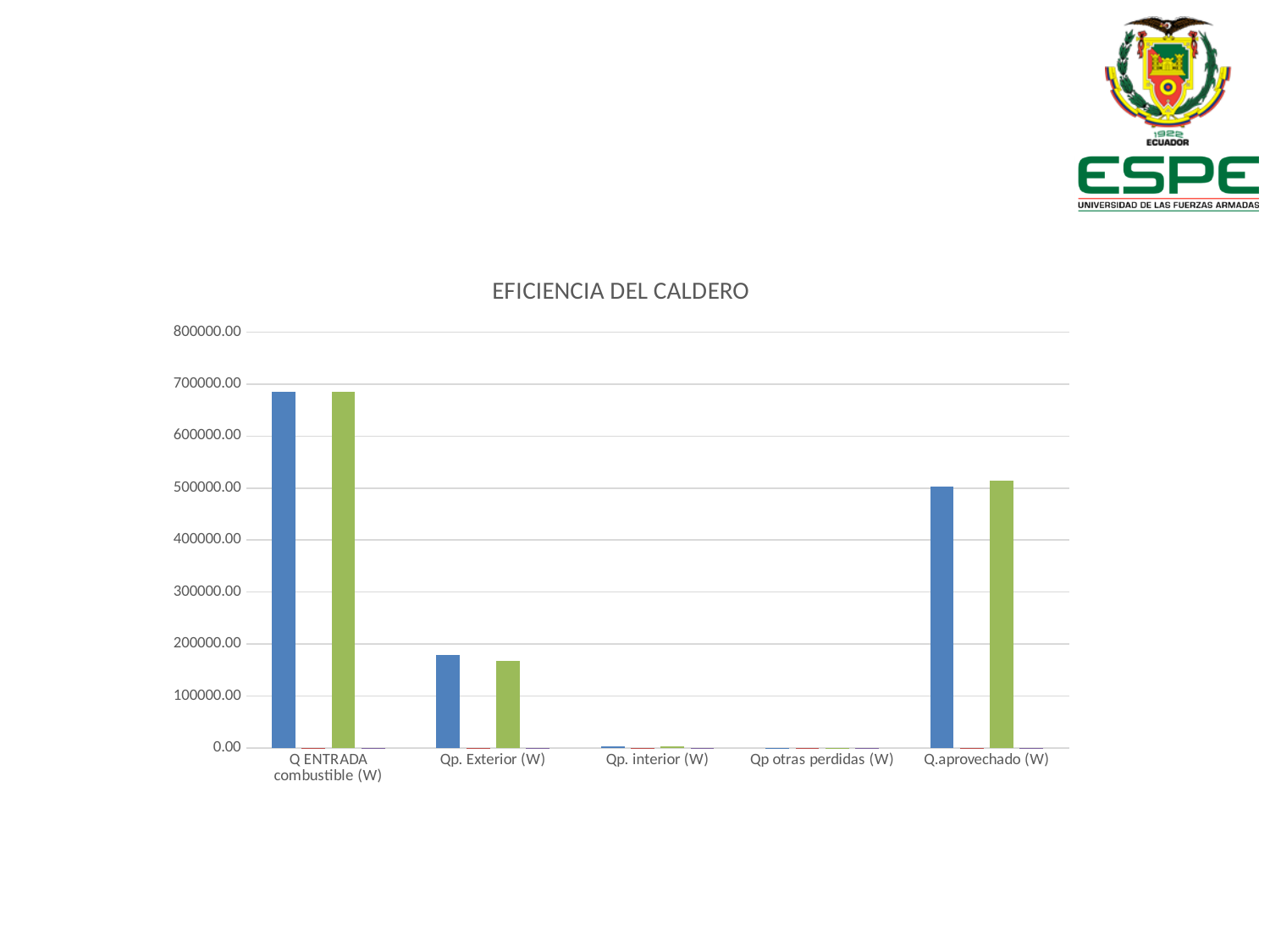
Is the value of the green bar for Q ENTRADA combustible (W) greater or less than 700000.00? less Which has the larger blue bar, Q ENTRADA combustible (W) or Q.aprovechado (W)? Q ENTRADA combustible (W) Is the value of the blue bar for Q ENTRADA combustible (W) greater or less than 600000.00? greater Is the value of the green bar for Qp. Exterior (W) greater or less than 100000.00? greater Which has the larger blue bar, Qp. Exterior (W) or Q.aprovechado (W)? Q.aprovechado (W) What is the title of the chart? EFICIENCIA DEL CALDERO How many categories are shown on the x axis of the chart? 5 What is the highest value shown on the y axis of the chart? 800000.00 What kind of chart is shown on the slide? bar chart Which category has the tallest bars in the chart? Q ENTRADA combustible (W)